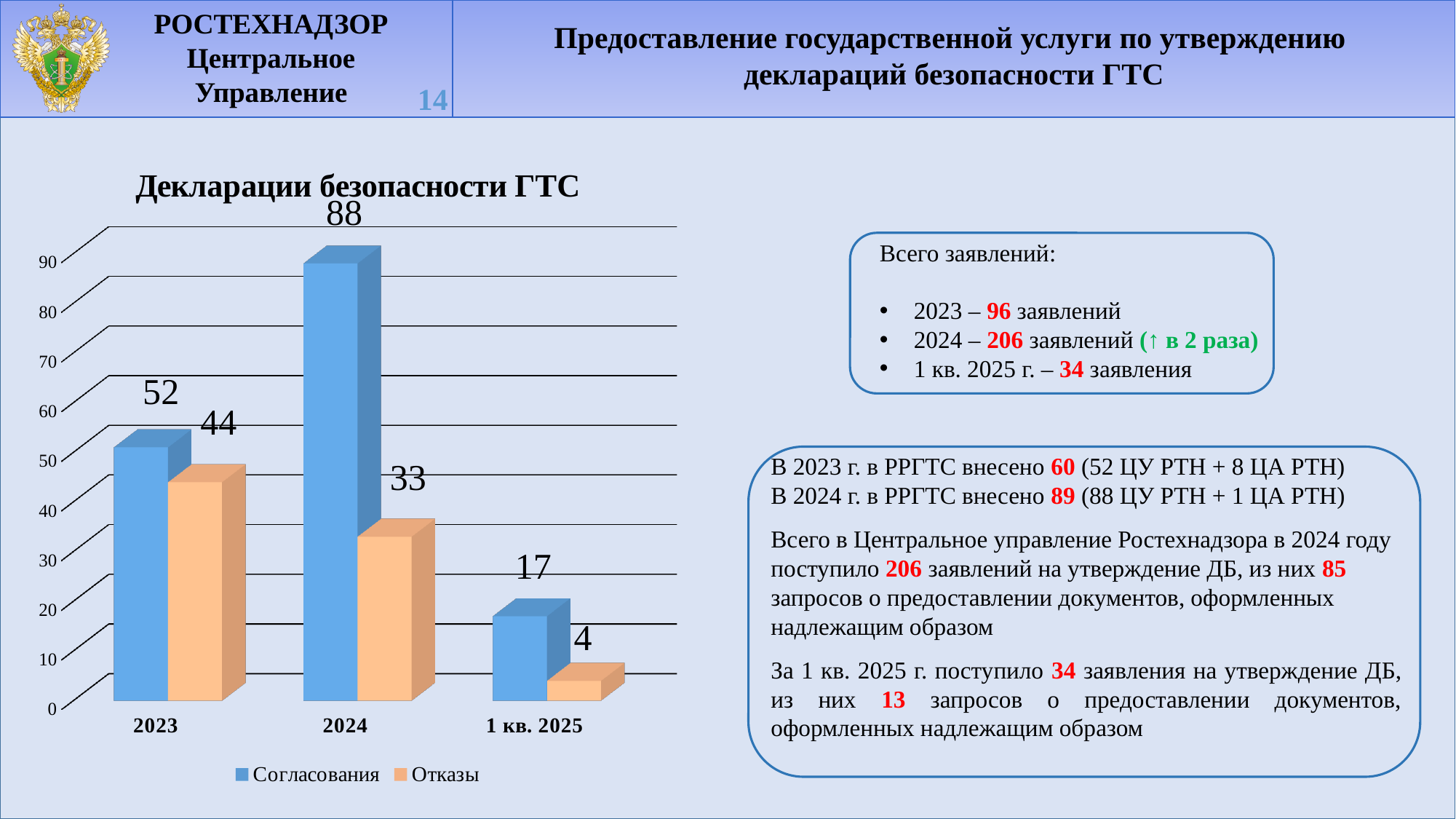
What is the value of Согласования for 1 кв. 2025? 17 What kind of chart is shown on the slide? Bar chart What is the value of Согласования for 2024? 88 Which is larger in 2023: Согласования or Отказы? Согласования What is the difference between Согласования and Отказы in 2024? 55 Which category has the lowest value for Отказы? 1 кв. 2025 What is the value of Отказы for 1 кв. 2025? 4 What is the value of Отказы for 2023? 44 Which category has the highest value for Согласования? 2024 What is the title of the chart? Декларации безопасности ГТС How many series does the legend list? 2 How many categories are shown on the x axis? 3